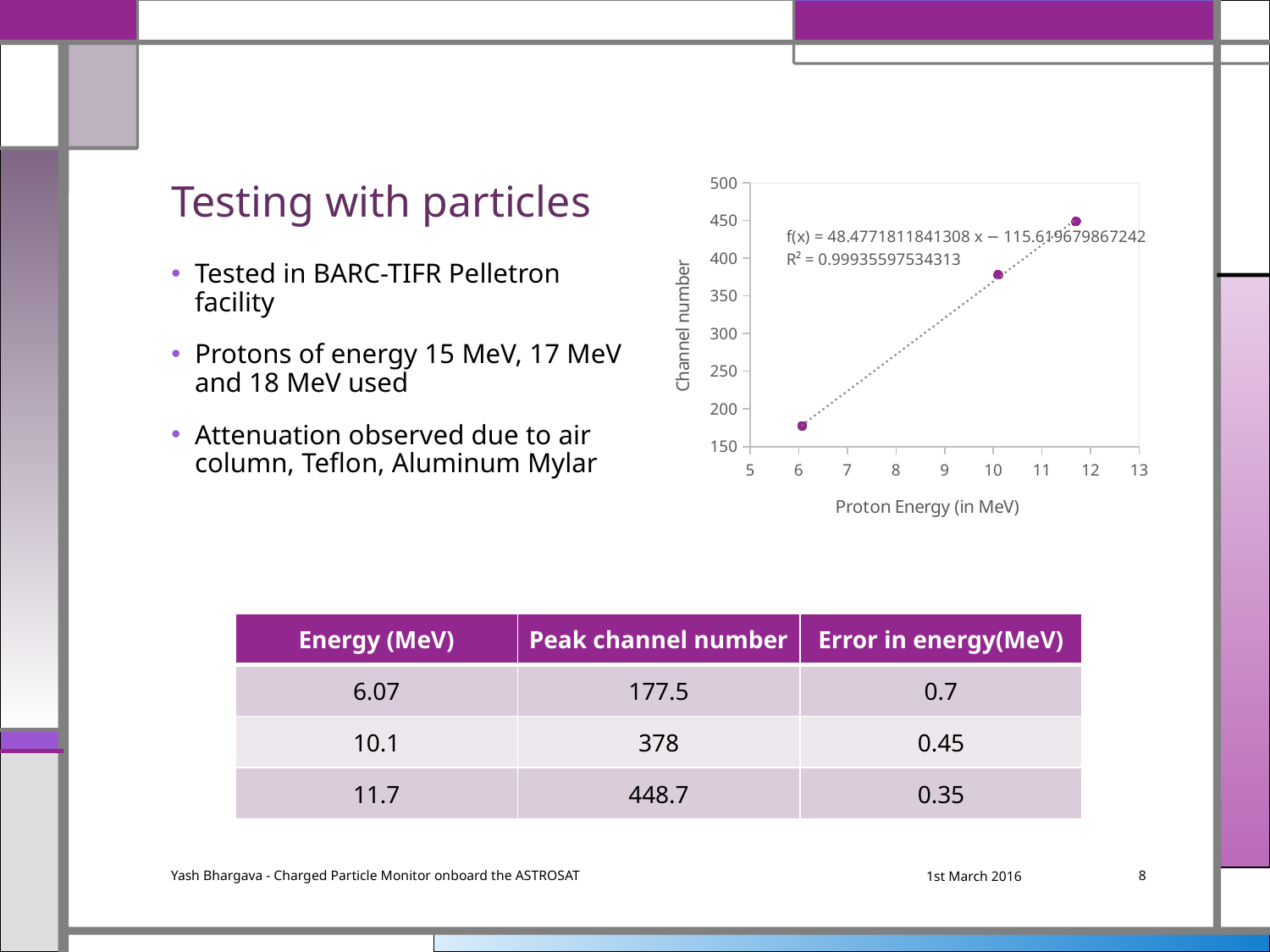
How many data points are plotted on the chart? 3 Which proton energy gives the highest channel number on the chart? 11.7 MeV What kind of chart is shown on the slide? scatter chart Is the channel number for the lowest-energy point (near 6 MeV) greater or less than 200? less What is the label of the y axis of the chart? Channel number Do the channel number values rise or fall as proton energy increases along the x axis? rise Is the channel number for the point near 10 MeV greater or less than 350? greater What R² value is printed on the chart for the fitted line? 0.99935597534313 According to the slide, what is the peak channel number for a proton energy of 10.1 MeV? 378 Is the channel number for the highest-energy point (near 12 MeV) greater or less than 400? greater What is the label of the x axis of the chart? Proton Energy (in MeV) What is the slope of the fitted line f(x) shown on the chart? 48.4771811841308